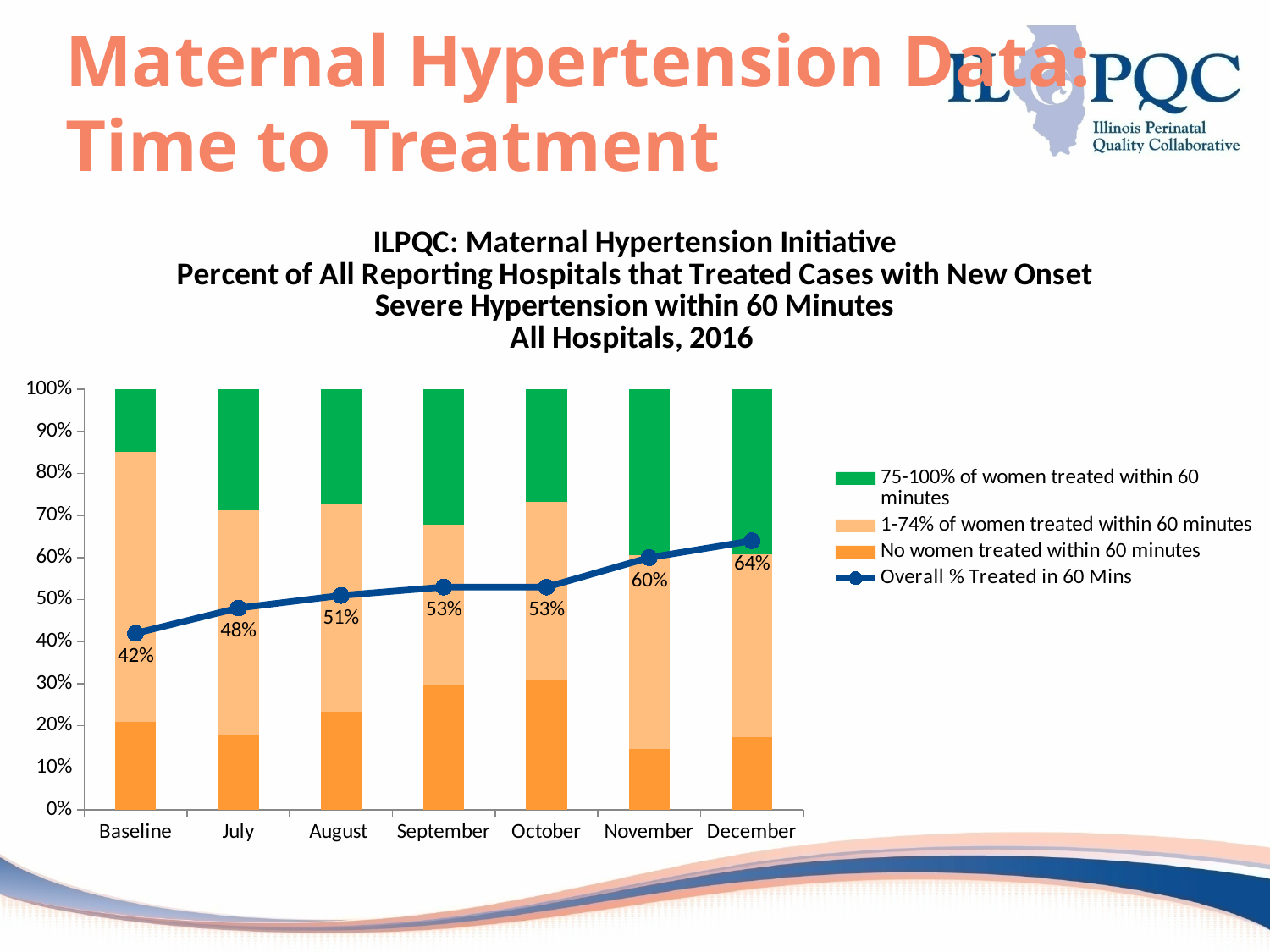
Does the Overall % Treated in 60 Mins line rise or fall from Baseline to December? Rise How many series does the legend list? 4 Which category has the lowest Overall % Treated in 60 Mins? Baseline What is the difference between the Overall % Treated in 60 Mins for December and Baseline? 22% What is the Overall % Treated in 60 Mins value for December? 64% Which is larger, the Overall % Treated in 60 Mins for November or for July? November What is the Overall % Treated in 60 Mins value for Baseline? 42% Which month has the highest Overall % Treated in 60 Mins? December Is the value for No women treated within 60 minutes in November greater or less than 20%? less What kind of chart is this? Stacked bar chart with a line What is the Overall % Treated in 60 Mins value for August? 51% How many categories are shown on the x axis? 7